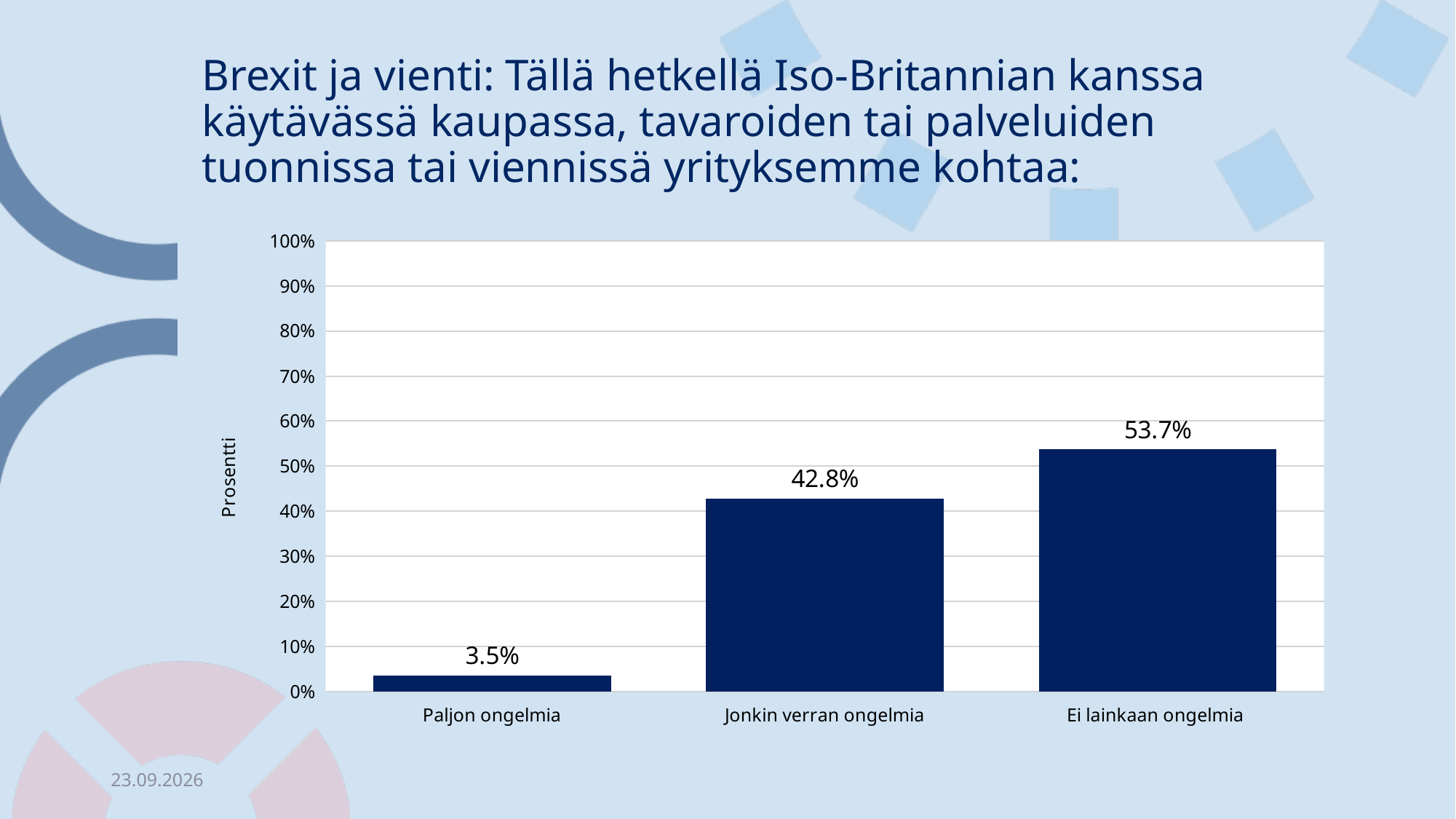
Which category has the lowest value? Paljon ongelmia What kind of chart is shown on the slide? Bar chart Which is larger, the value for "Jonkin verran ongelmia" or the value for "Ei lainkaan ongelmia"? Ei lainkaan ongelmia What is the label of the vertical axis? Prosentti What is the difference between the values for "Ei lainkaan ongelmia" and "Jonkin verran ongelmia"? 10.9% What is the value for "Paljon ongelmia"? 3.5% Which category has the highest value? Ei lainkaan ongelmia What is the value for "Jonkin verran ongelmia"? 42.8% What is the difference between the values for "Jonkin verran ongelmia" and "Paljon ongelmia"? 39.3% Is the value for "Ei lainkaan ongelmia" greater or less than 50%? greater How many categories are shown on the x axis? 3 What is the value for "Ei lainkaan ongelmia"? 53.7%